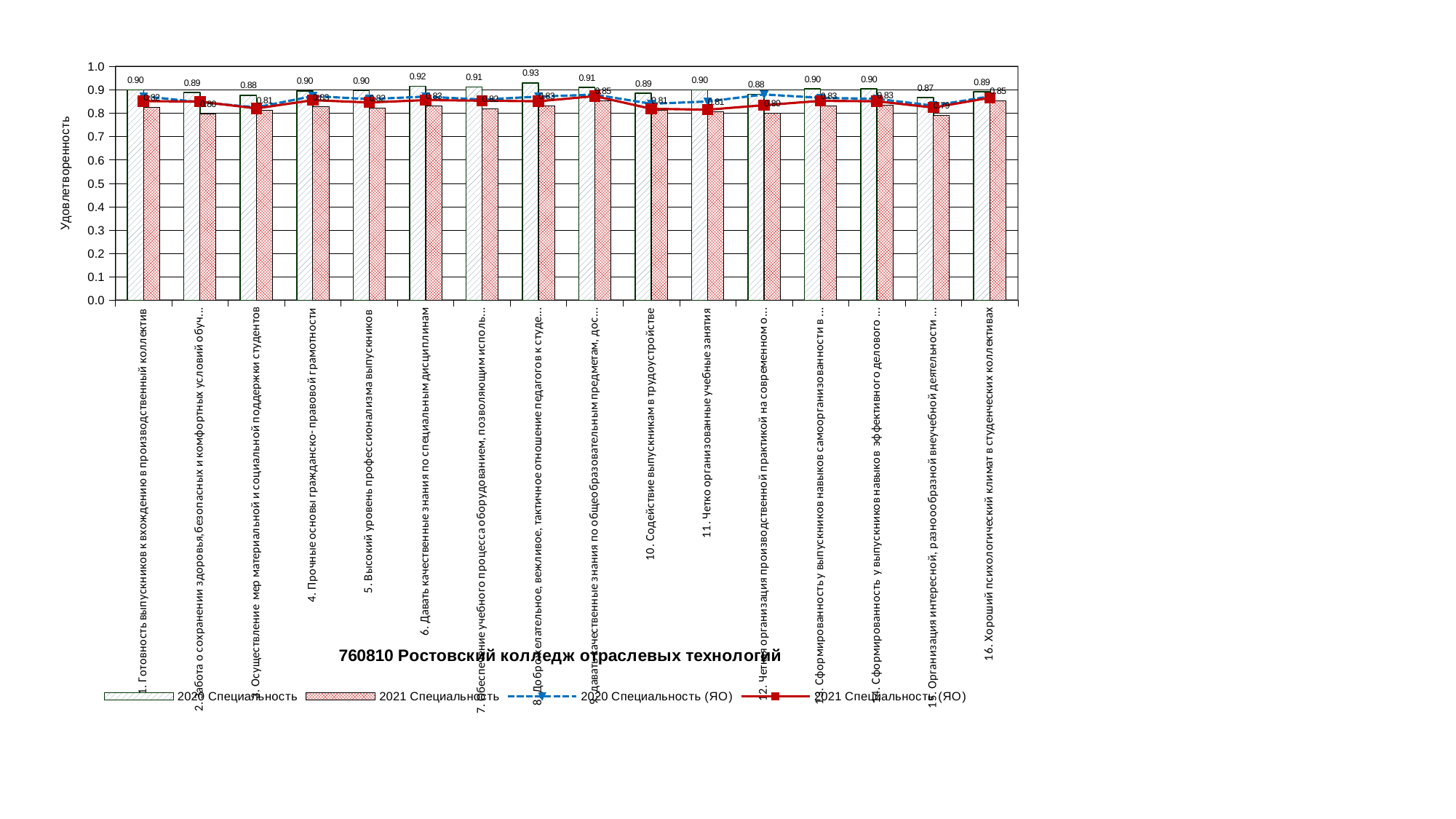
What is the value of the 2020 Специальность series for category 1 (Готовность выпускников к вхождению в производственный коллектив)? 0.90 What is the difference between the 2020 Специальность and 2021 Специальность values for category 16 (Хороший психологический климат в студенческих коллективах)? 0.04 How many categories are shown on the x axis? 16 What is the value of the 2021 Специальность series for category 15 (Организация интересной, разнообразной внеучебной деятельности)? 0.79 What is the value of the 2020 Специальность series for category 8 (Доброжелательное, вежливое, тактичное отношение педагогов к студентам)? 0.93 What label is shown on the vertical axis? Удовлетворенность For category 3 (Осуществление мер материальной и социальной поддержки студентов), which is larger: the 2020 Специальность value or the 2021 Специальность value? 2020 Специальность How many series does the legend list? 4 Which category has the highest value in the 2020 Специальность series? 8. Доброжелательное, вежливое, тактичное отношение педагогов к студентам What is the value of the 2021 Специальность series for category 16 (Хороший психологический климат в студенческих коллективах)? 0.85 Which category has the lowest value in the 2020 Специальность series? 15. Организация интересной, разнообразной внеучебной деятельности What is the title of the chart? 760810 Ростовский колледж отраслевых технологий